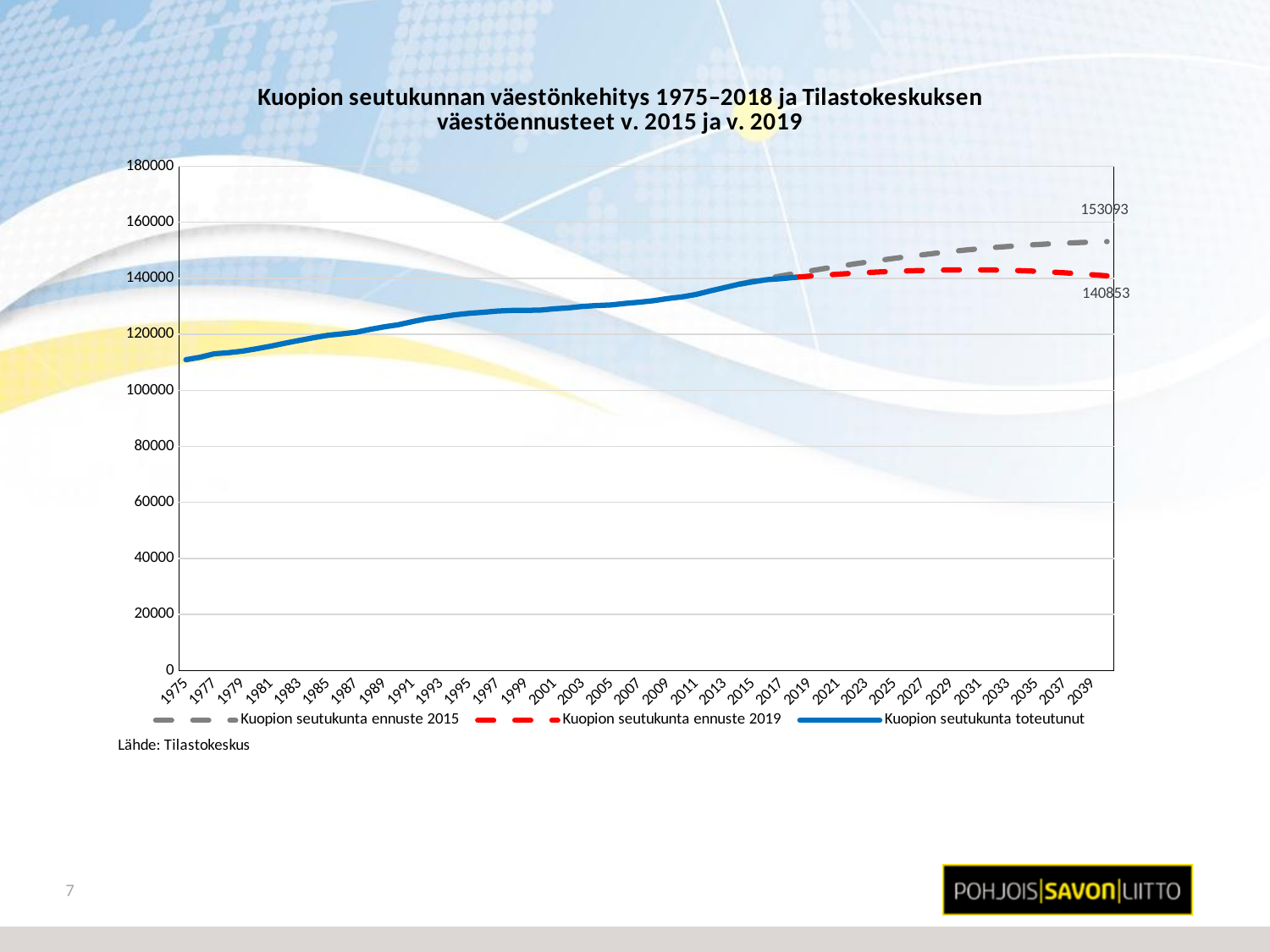
What is the difference between the final labelled values of the 2015 forecast (153093) and the 2019 forecast (140853)? 12240 What is the final labelled value of the series 'Kuopion seutukunta ennuste 2015'? 153093 What colour is the line for 'Kuopion seutukunta toteutunut'? blue What is the first year shown on the x axis? 1975 Is the value of 'Kuopion seutukunta toteutunut' in 1975 greater or less than 120000? less What is the final labelled value of the series 'Kuopion seutukunta ennuste 2019'? 140853 Does the 'Kuopion seutukunta toteutunut' series rise or fall from 1975 to 2017? rises What kind of chart is shown on the slide? line chart How many series does the legend list? 3 Is the value of 'Kuopion seutukunta toteutunut' in 2013 greater or less than 120000? greater Which forecast series ends at a higher value, 'ennuste 2015' or 'ennuste 2019'? Kuopion seutukunta ennuste 2015